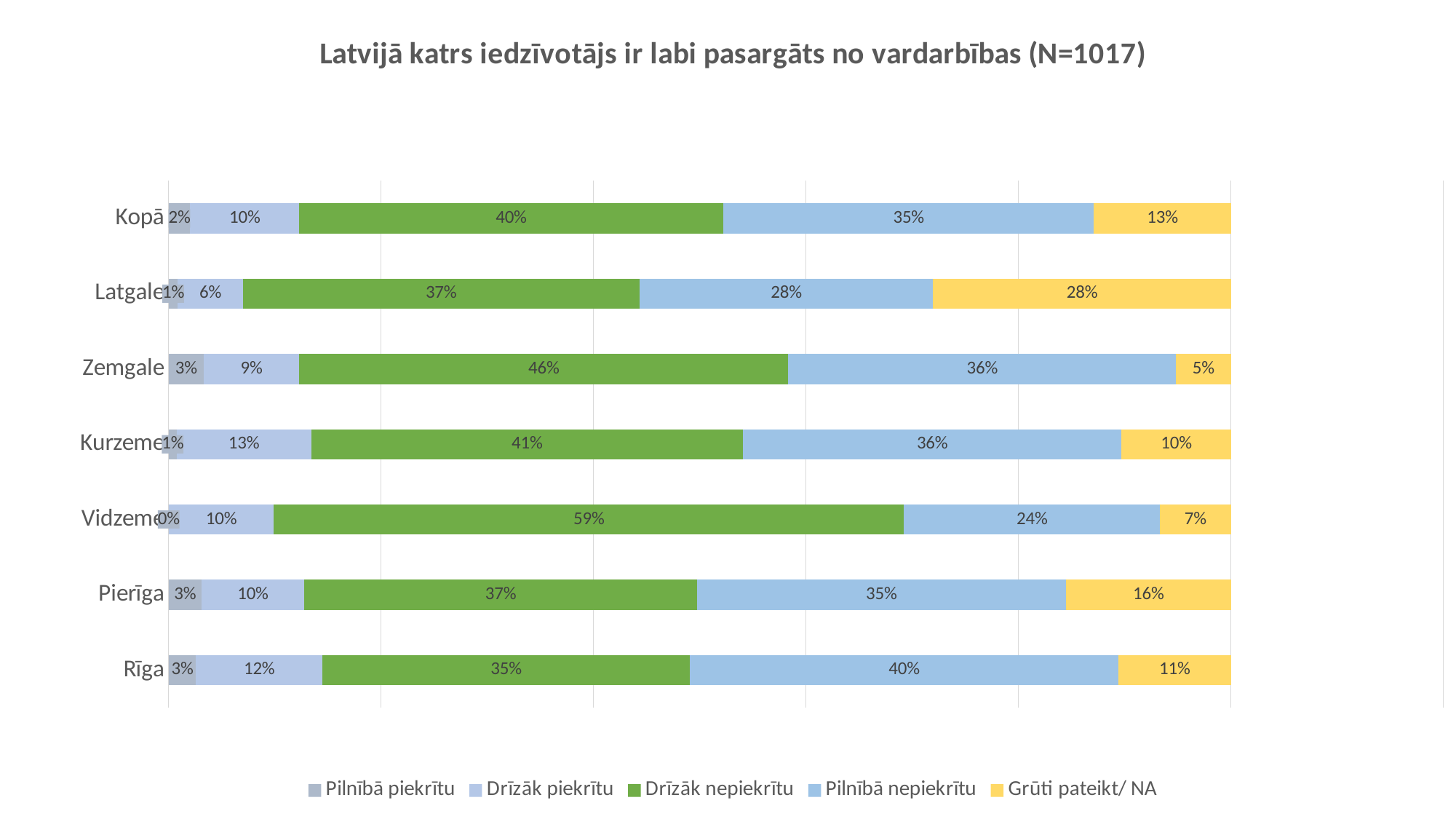
What is the value for "Grūti pateikt/ NA" in the Latgale bar? 28% What kind of chart is shown on the slide? Stacked bar chart Which has the larger "Drīzāk piekrītu" value, Kurzeme or Latgale? Kurzeme What is the total of all segments in the Kopā bar? 100% What is the title of the chart? Latvijā katrs iedzīvotājs ir labi pasargāts no vardarbības (N=1017) What is the difference between the "Drīzāk nepiekrītu" values for Vidzeme and Rīga? 24 percentage points What is the value for "Pilnībā nepiekrītu" in the Rīga bar? 40% How many regions (bars) are shown in the chart? 7 Which region has the highest value for "Drīzāk nepiekrītu"? Vidzeme Which region has the lowest value for "Grūti pateikt/ NA"? Zemgale How many series does the legend list? 5 What is the value for "Drīzāk nepiekrītu" in the Vidzeme bar? 59%